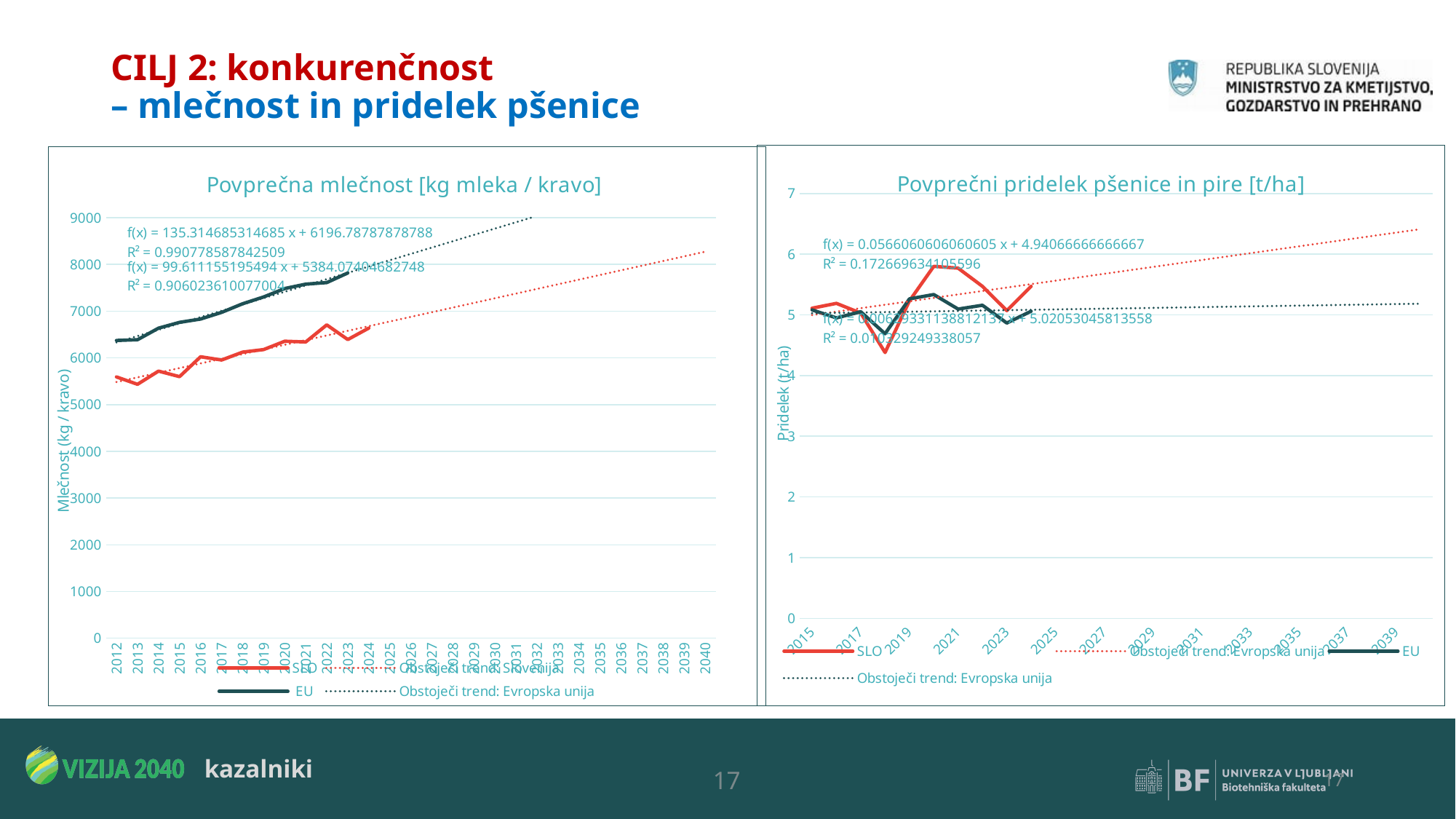
In the left chart 'Povprečna mlečnost', is the SLO value for 2012 greater or less than 6000? less In the left chart 'Povprečna mlečnost', is the SLO value for 2024 greater or less than 7000? less In the left chart 'Povprečna mlečnost', does the SLO series generally rise or fall from 2012 to 2024? rise In the right chart 'Povprečni pridelek pšenice in pire', is the SLO value for 2021 greater or less than 5? greater In the right chart 'Povprečni pridelek pšenice in pire', which series is higher in 2021, SLO or EU? SLO What kind of chart is the left chart, 'Povprečna mlečnost [kg mleka / kravo]'? line chart What is the y-axis label of the left chart 'Povprečna mlečnost'? Mlečnost (kg / kravo) What is the title of the right chart? Povprečni pridelek pšenice in pire [t/ha] In the left chart 'Povprečna mlečnost', how many entries does the legend list? 4